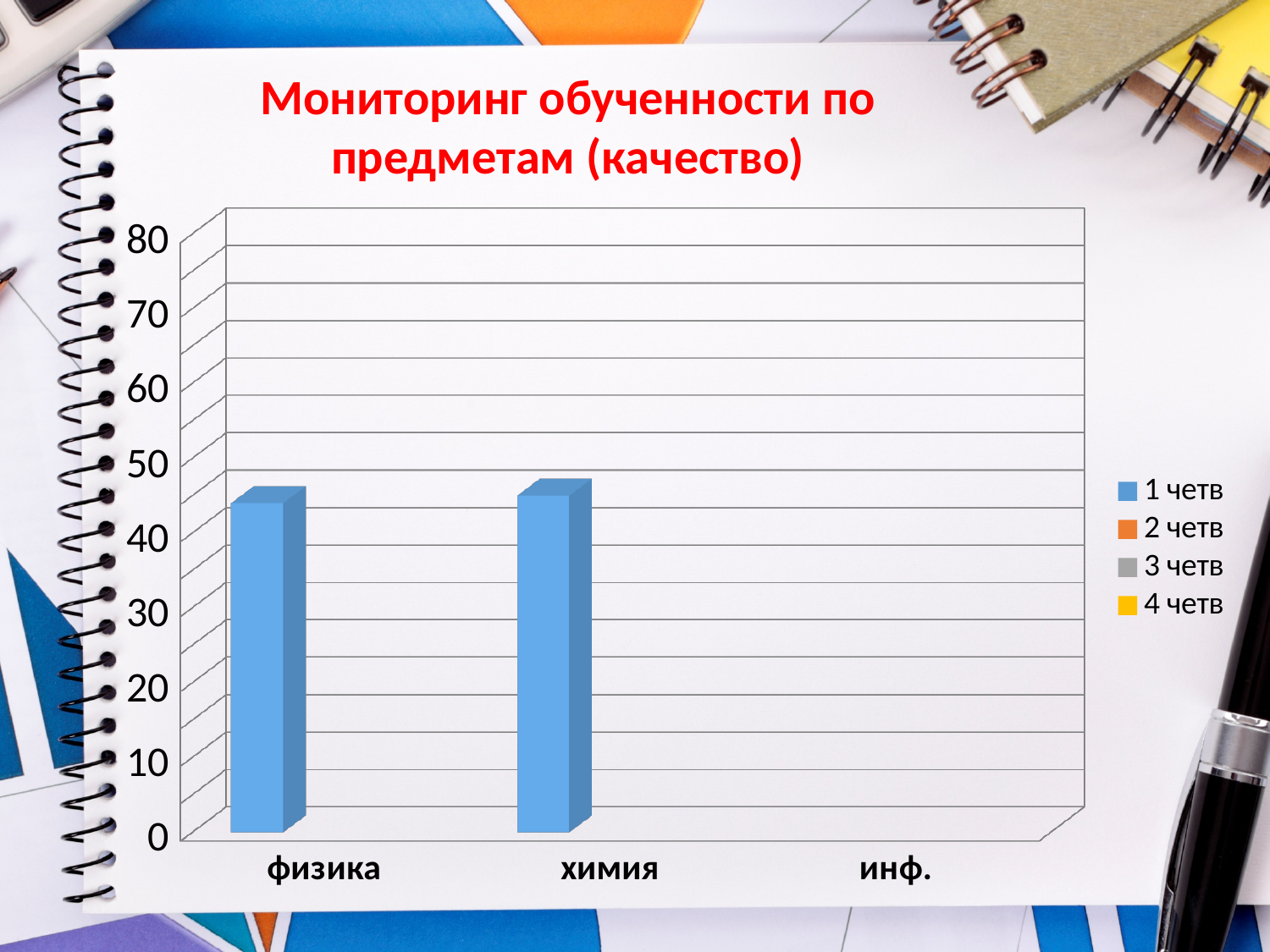
What is the highest value shown on the vertical axis? 80 Is the value for физика (1 четв) greater or less than 40? greater Is the value for химия (1 четв) greater or less than 40? greater How many series does the legend list? 4 What is the title of the chart? Мониторинг обученности по предметам (качество) Is the value for химия (1 четв) greater or less than 60? less What kind of chart is shown on the slide? bar chart How many categories are shown on the x axis? 3 Which category has no bar plotted? инф.